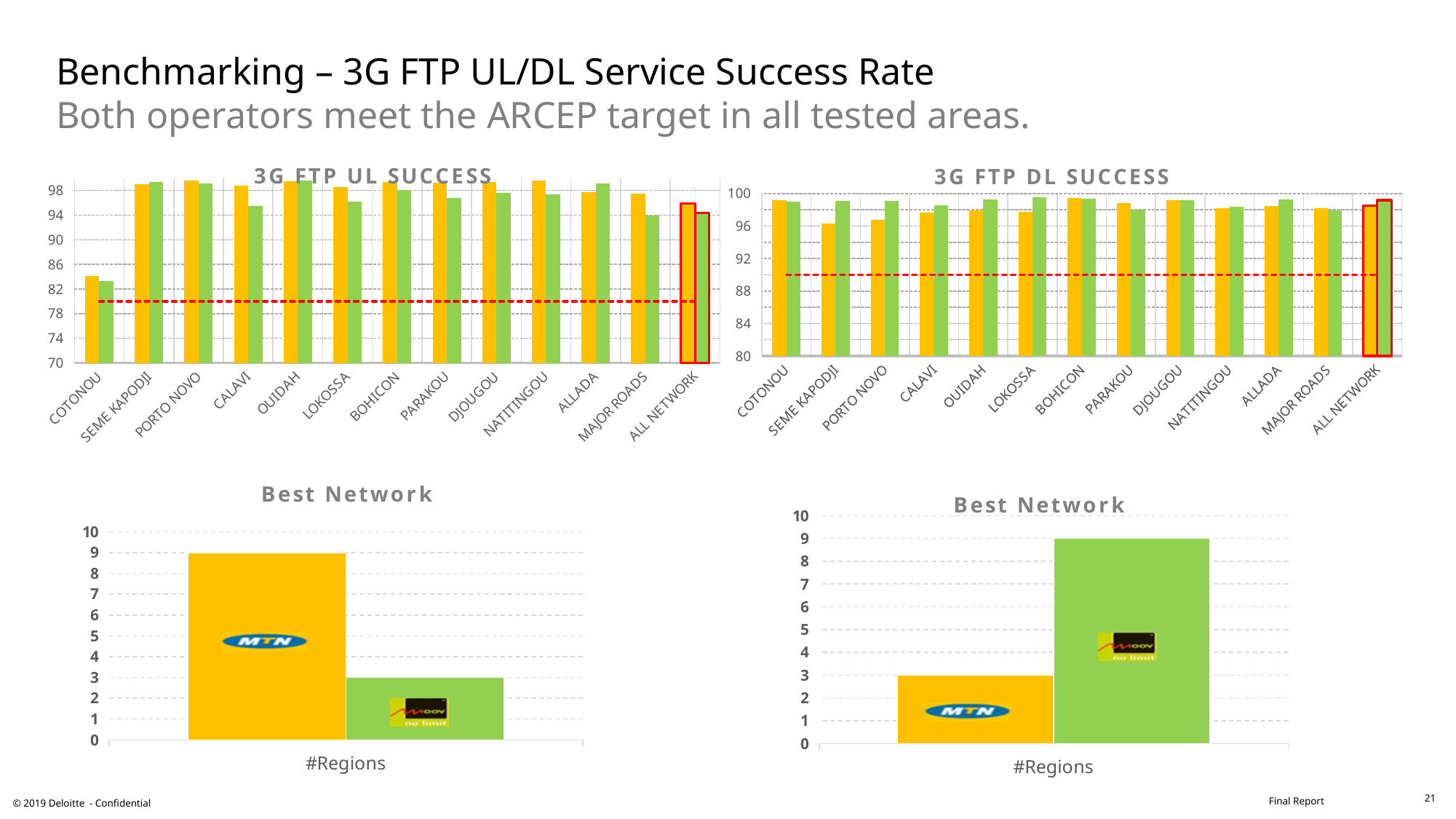
In the '3G FTP DL SUCCESS' chart, is the yellow bar for SEME KAPODJI greater or less than 92? greater What kind of chart is the '3G FTP UL SUCCESS' chart? bar chart In the bottom-left 'Best Network' chart, what is the difference between the MTN bar and the Moov bar? 6 In the bottom-right 'Best Network' chart, which bar is larger, MTN or Moov? Moov In the bottom-left 'Best Network' chart, what is the value of the MTN bar? 9 How many categories are shown on the x axis of the '3G FTP UL SUCCESS' chart? 13 In the bottom-right 'Best Network' chart, what is the value of the Moov bar? 9 In the '3G FTP UL SUCCESS' chart, which category has the lowest values? COTONOU In the '3G FTP UL SUCCESS' chart, is the green bar for MAJOR ROADS greater or less than 90? greater In the '3G FTP UL SUCCESS' chart, is the yellow bar for COTONOU greater or less than 90? less